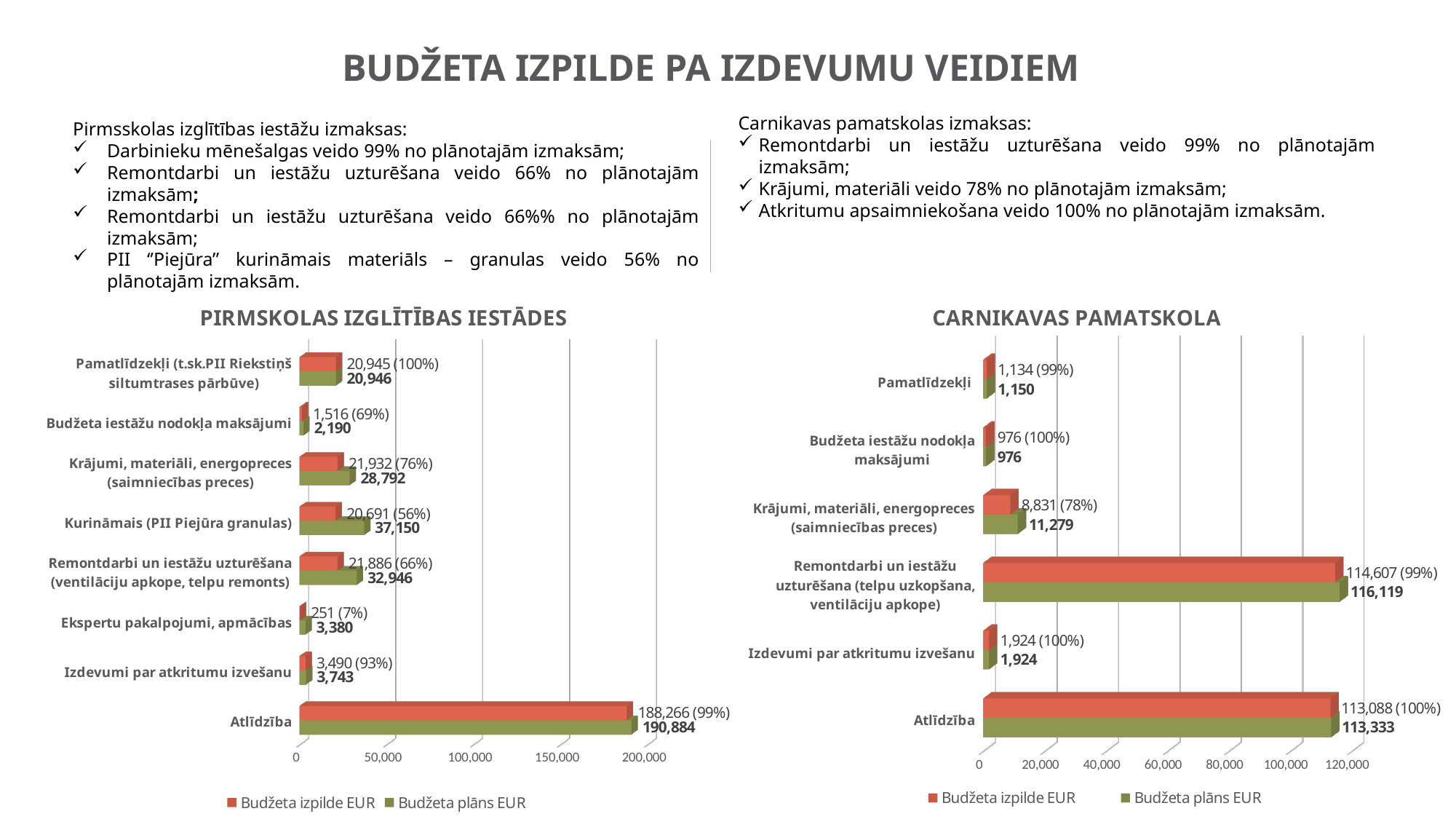
What type of chart is the PIRMSKOLAS IZGLĪTĪBAS IESTĀDES chart? Bar chart How many series does the legend of the CARNIKAVAS PAMATSKOLA chart list? 2 On the CARNIKAVAS PAMATSKOLA chart, what is the Budžeta izpilde EUR value for Krājumi, materiāli, energopreces (saimniecības preces)? 8,831 On the CARNIKAVAS PAMATSKOLA chart, which is larger: the Budžeta izpilde EUR value for Pamatlīdzekļi or for Izdevumi par atkritumu izvešanu? Izdevumi par atkritumu izvešanu On the PIRMSKOLAS IZGLĪTĪBAS IESTĀDES chart, what is the difference between the Budžeta plāns EUR and Budžeta izpilde EUR values for Kurināmais (PII Piejūra granulas)? 16,459 On the PIRMSKOLAS IZGLĪTĪBAS IESTĀDES chart, what is the Budžeta izpilde EUR value for Atlīdzība? 188,266 On the PIRMSKOLAS IZGLĪTĪBAS IESTĀDES chart, which category has the lowest Budžeta izpilde EUR value? Ekspertu pakalpojumi, apmācības How many categories are shown on the PIRMSKOLAS IZGLĪTĪBAS IESTĀDES chart? 8 On the PIRMSKOLAS IZGLĪTĪBAS IESTĀDES chart, what is the Budžeta plāns EUR value for Kurināmais (PII Piejūra granulas)? 37,150 On the CARNIKAVAS PAMATSKOLA chart, which category has the highest Budžeta plāns EUR value? Remontdarbi un iestāžu uzturēšana (telpu uzkopšana, ventilāciju apkope) On the CARNIKAVAS PAMATSKOLA chart, what is the difference between the Budžeta plāns EUR and Budžeta izpilde EUR values for Krājumi, materiāli, energopreces (saimniecības preces)? 2,448 On the CARNIKAVAS PAMATSKOLA chart, what is the Budžeta plāns EUR value for Remontdarbi un iestāžu uzturēšana (telpu uzkopšana, ventilāciju apkope)? 116,119